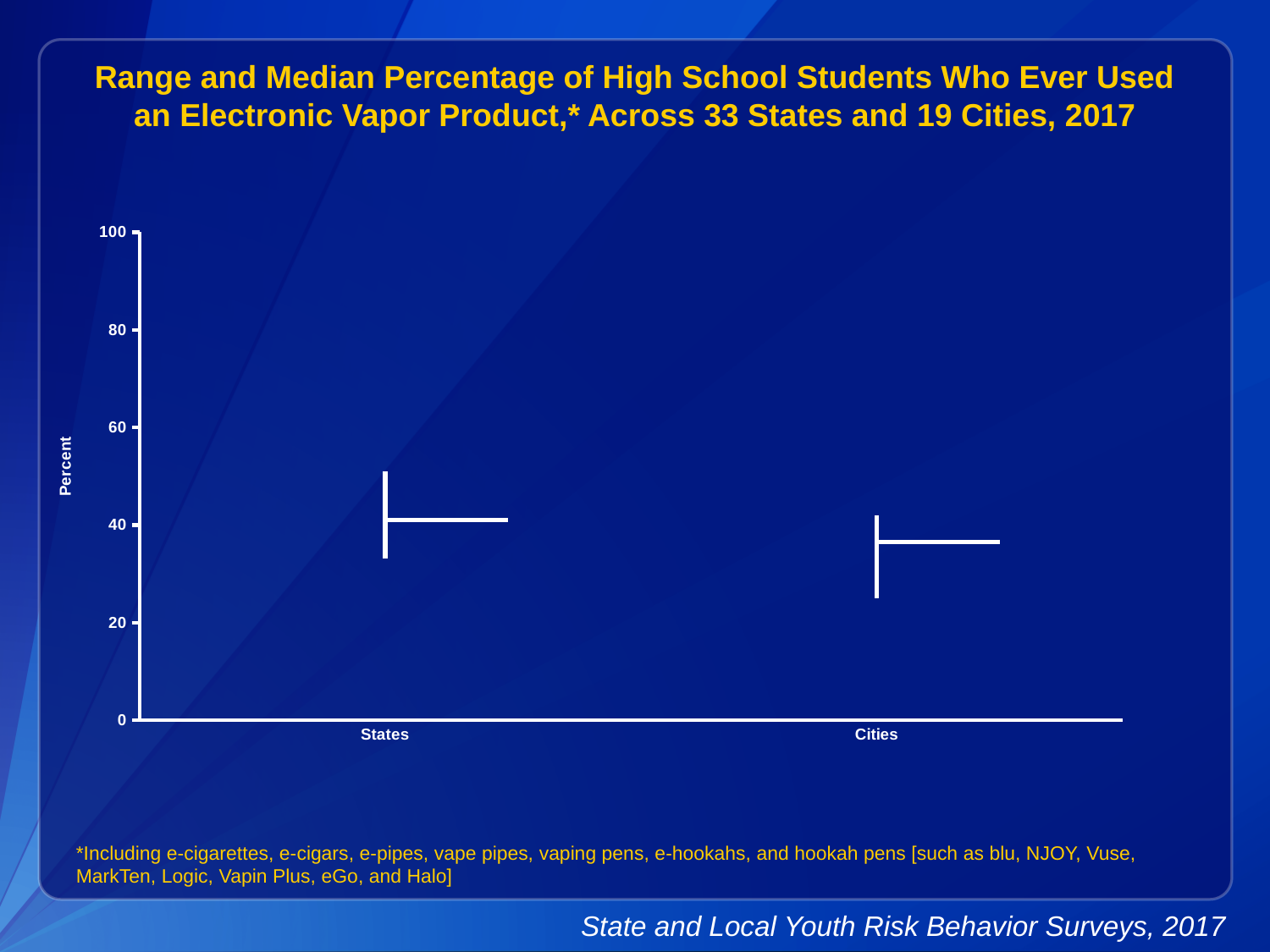
Is the top of the range for States greater or less than 40? greater Is the median value for Cities greater or less than 20? greater Which category has the lower bottom of its range, States or Cities? Cities Is the top of the range for Cities greater or less than 60? less Which category has the higher median value, States or Cities? States What are the two categories shown on the x axis? States and Cities How many categories are shown on the x axis of the chart? 2 What is the label of the y axis? Percent